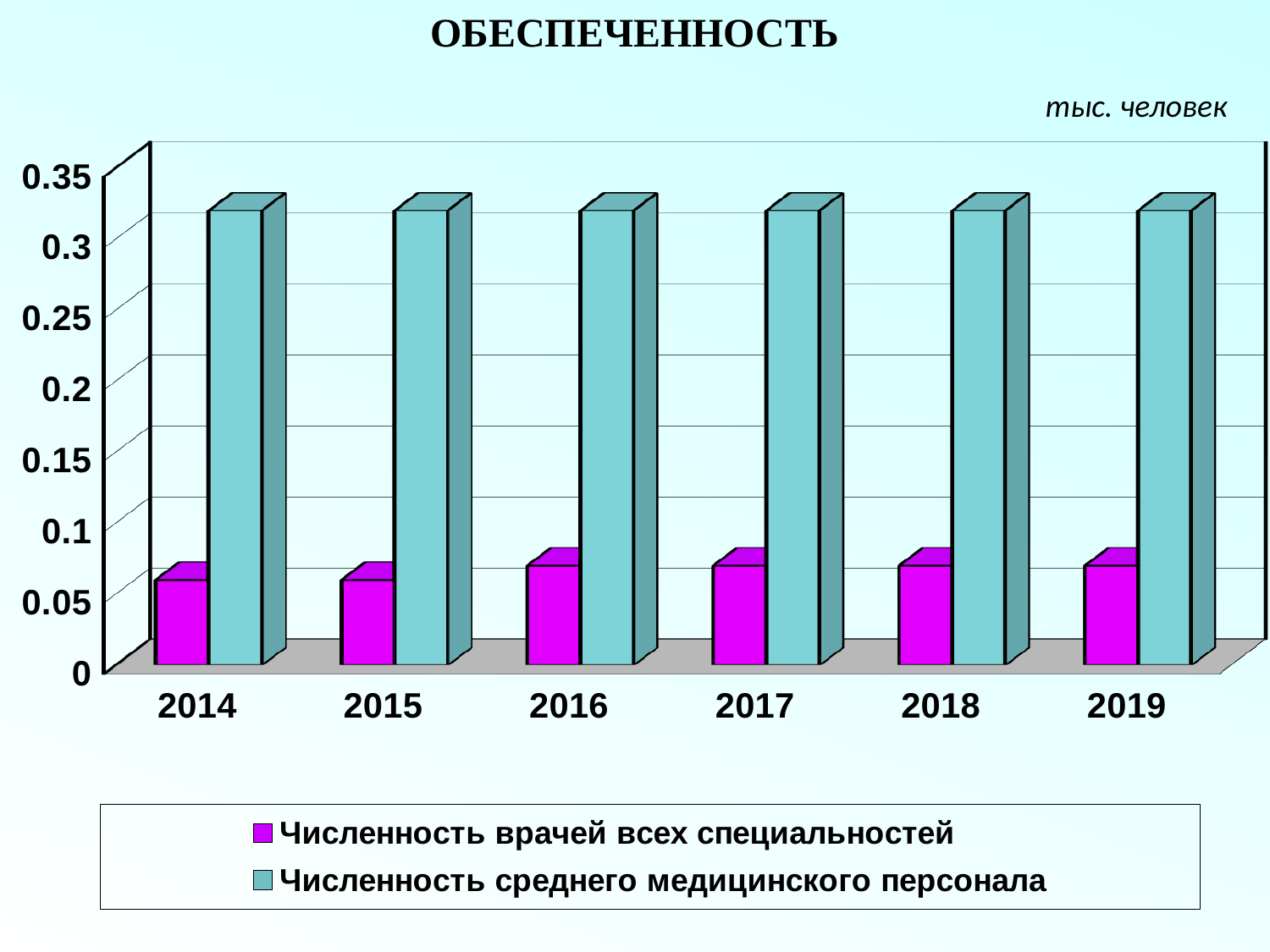
How many series does the legend list? 2 Is the value for Численность среднего медицинского персонала in 2019 greater or less than 0.35? less Which series is shown in magenta in the chart? Численность врачей всех специальностей In 2017, which series has the larger value: Численность врачей всех специальностей or Численность среднего медицинского персонала? Численность среднего медицинского персонала Is the value for Численность врачей всех специальностей in 2014 greater or less than 0.05? greater What unit is indicated above the chart? тыс. человек How many years are shown on the x axis of the chart? 6 Is the value for Численность среднего медицинского персонала in 2016 greater or less than 0.2? greater What is the title of the chart? ОБЕСПЕЧЕННОСТЬ What kind of chart is shown on the slide? Bar chart